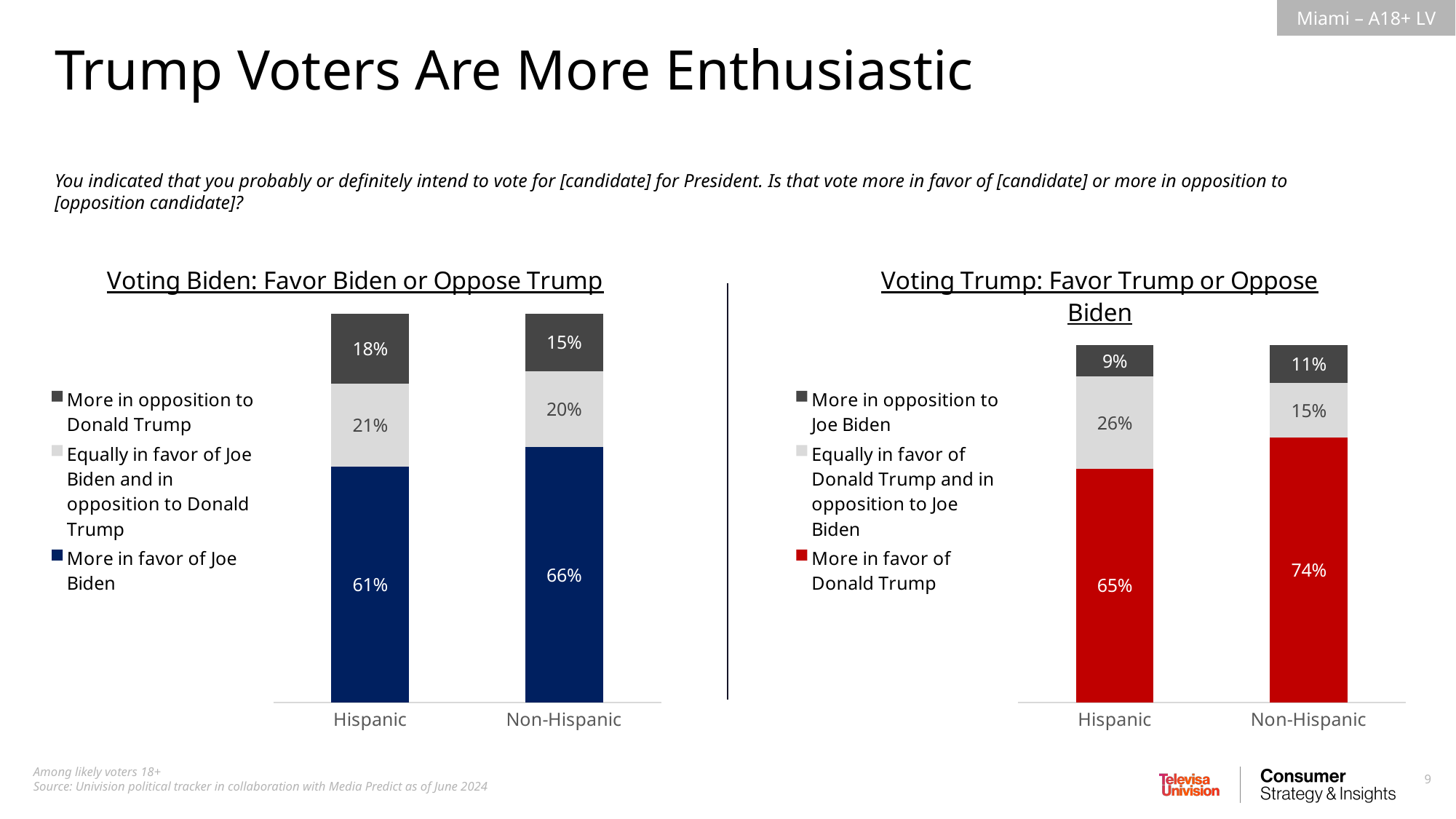
What kind of chart is the 'Voting Trump: Favor Trump or Oppose Biden' chart? Stacked bar chart In the 'Voting Biden: Favor Biden or Oppose Trump' chart, which group has the higher 'More in favor of Joe Biden' value, Hispanic or Non-Hispanic? Non-Hispanic In the 'Voting Trump: Favor Trump or Oppose Biden' chart, what is the difference between the Non-Hispanic and Hispanic 'More in favor of Donald Trump' values? 9 percentage points In the 'Voting Biden: Favor Biden or Oppose Trump' chart, what percentage of Non-Hispanic voters are 'More in opposition to Donald Trump'? 15% In the 'Voting Biden: Favor Biden or Oppose Trump' chart, what percentage of Hispanic voters are 'More in favor of Joe Biden'? 61% In the 'Voting Biden: Favor Biden or Oppose Trump' chart, what is the total of the Hispanic stacked bar? 100% In the 'Voting Trump: Favor Trump or Oppose Biden' chart, what percentage of Hispanic voters are 'Equally in favor of Donald Trump and in opposition to Joe Biden'? 26% How many series does the legend of the 'Voting Trump: Favor Trump or Oppose Biden' chart list? 3 In the 'Voting Trump: Favor Trump or Oppose Biden' chart, what percentage of Non-Hispanic voters are 'More in favor of Donald Trump'? 74% In the 'Voting Biden: Favor Biden or Oppose Trump' chart, what colour represents 'More in favor of Joe Biden'? Dark blue How many categories are shown on the x axis of the 'Voting Biden: Favor Biden or Oppose Trump' chart? 2 In the 'Voting Trump: Favor Trump or Oppose Biden' chart, which group has the lower 'More in opposition to Joe Biden' value? Hispanic